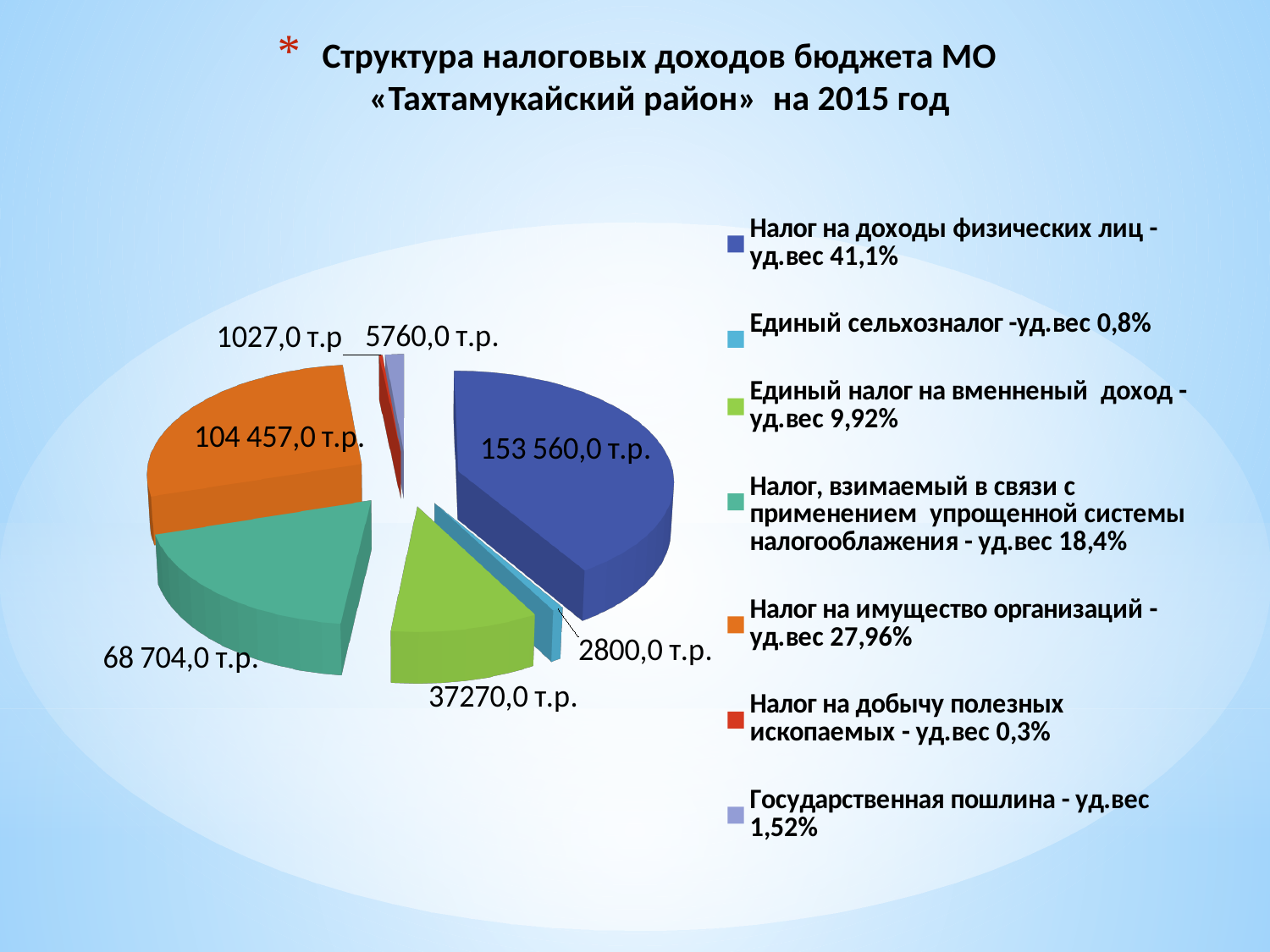
What is the value shown for Налог на доходы физических лиц? 153 560,0 т.р. Which is larger: the value for Налог, взимаемый в связи с применением упрощенной системы налогооблажения or the value for Единый налог на вмененный доход? Налог, взимаемый в связи с применением упрощенной системы налогооблажения What is the title of the chart on the slide? Структура налоговых доходов бюджета МО «Тахтамукайский район» на 2015 год What is the value shown for Налог на имущество организаций? 104 457,0 т.р. How many slices does the pie chart have? 7 What is the value shown for Единый сельхозналог? 2800,0 т.р. Which category has the largest slice of the pie? Налог на доходы физических лиц What type of chart is shown on the slide? pie chart What is the value shown for Единый налог на вмененный доход? 37270,0 т.р. What share of the pie does Налог на имущество организаций represent, according to the legend? 27,96% How many entries does the legend list? 7 Which category has the smallest slice of the pie? Налог на добычу полезных ископаемых